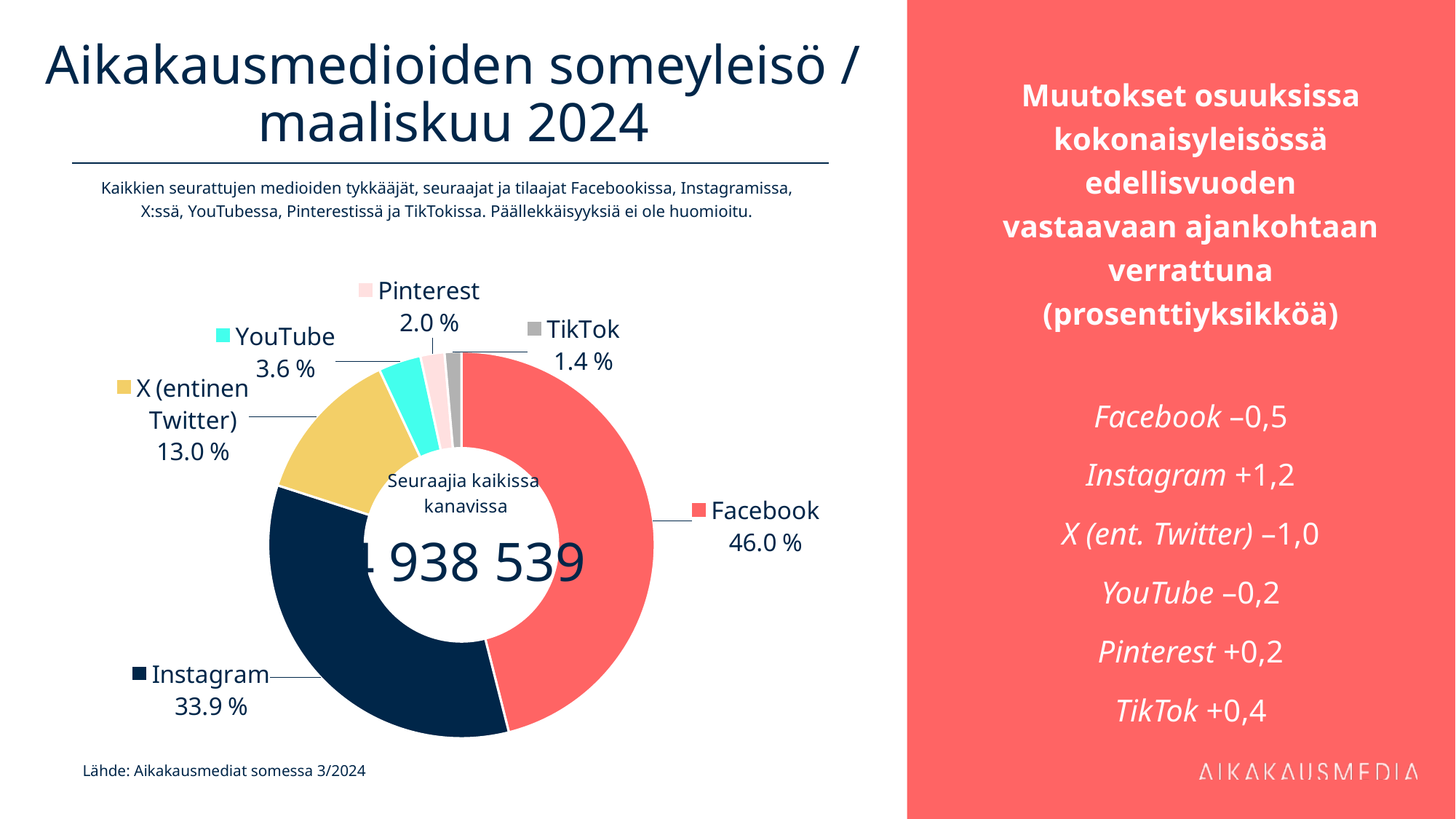
How many platforms are shown in the chart? 6 What share of the social media audience does Instagram have? 33.9 % What is the difference in percentage points between Facebook's and Instagram's shares? 12.1 Which platform has the smallest share in the chart? TikTok What share of the social media audience does Facebook have? 46.0 % Which has a larger share, Pinterest or YouTube? YouTube Which platform has the largest share in the chart? Facebook What kind of chart is shown on the slide? Pie chart (donut) What is the combined share of Pinterest and TikTok? 3.4 % What share does YouTube have in the chart? 3.6 % What share does TikTok have in the chart? 1.4 % What share does X (entinen Twitter) have in the chart? 13.0 %